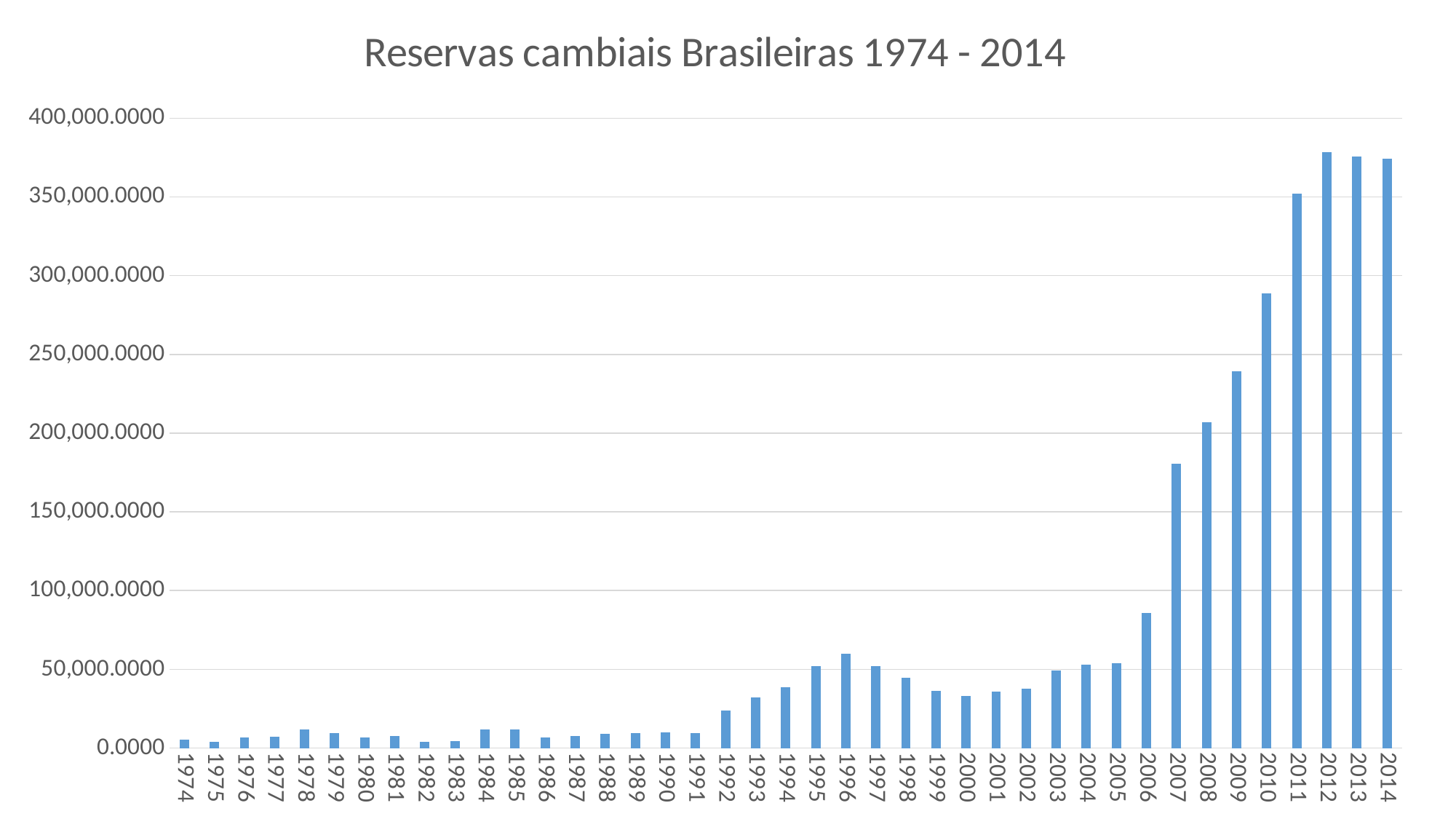
Is the value for 2007 greater or less than 150,000.0000? greater What is the title of the chart? Reservas cambiais Brasileiras 1974 - 2014 Is the value for 2000 greater or less than 50,000.0000? less Is the value for 2010 greater or less than 250,000.0000? greater Which year has the larger value, 2009 or 2010? 2010 How many years (bars) are plotted on the chart? 41 What kind of chart is shown on the slide? bar chart Which year has the larger value, 1995 or 1996? 1996 Overall, do the values rise or fall from 1974 to 2014? rise